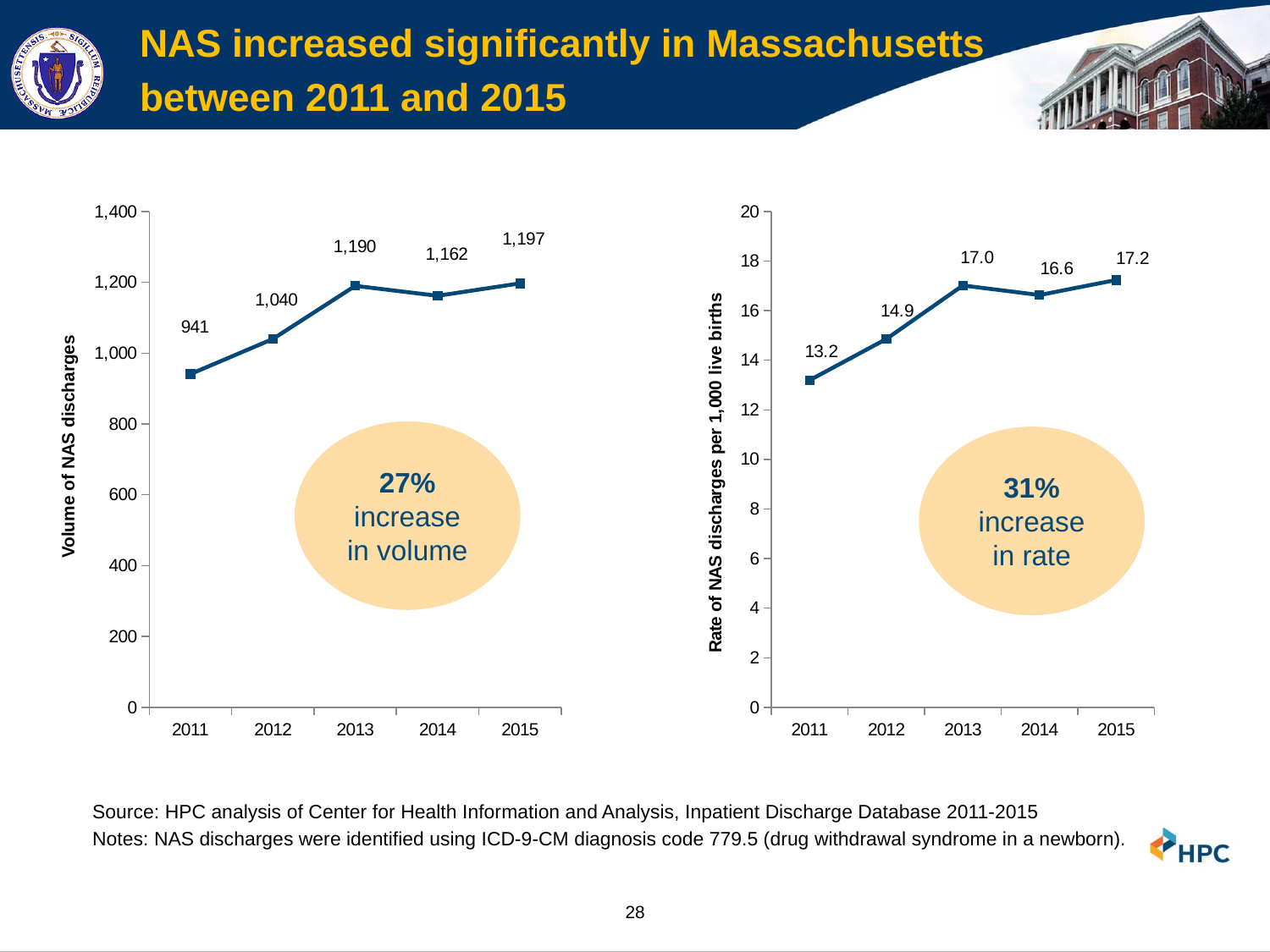
In the left chart (Volume of NAS discharges), what is the value for 2014? 1,162 In the left chart (Volume of NAS discharges), which year has the highest value? 2015 In the right chart (Rate of NAS discharges per 1,000 live births), what is the value for 2015? 17.2 In the right chart (Rate of NAS discharges per 1,000 live births), what is the value for 2012? 14.9 How many years are plotted in the right chart (Rate of NAS discharges per 1,000 live births)? 5 What kind of chart is the left chart (Volume of NAS discharges)? Line chart In the right chart (Rate of NAS discharges per 1,000 live births), do the values generally rise or fall from 2011 to 2015? Rise In the right chart (Rate of NAS discharges per 1,000 live births), which year has the lowest value? 2011 In the right chart (Rate of NAS discharges per 1,000 live births), what is the difference between the 2013 value and the 2014 value? 0.4 In the left chart (Volume of NAS discharges), which is larger, the value for 2013 or the value for 2014? 2013 In the left chart (Volume of NAS discharges), what is the value for 2011? 941 In the left chart (Volume of NAS discharges), what is the difference between the 2015 value and the 2011 value? 256